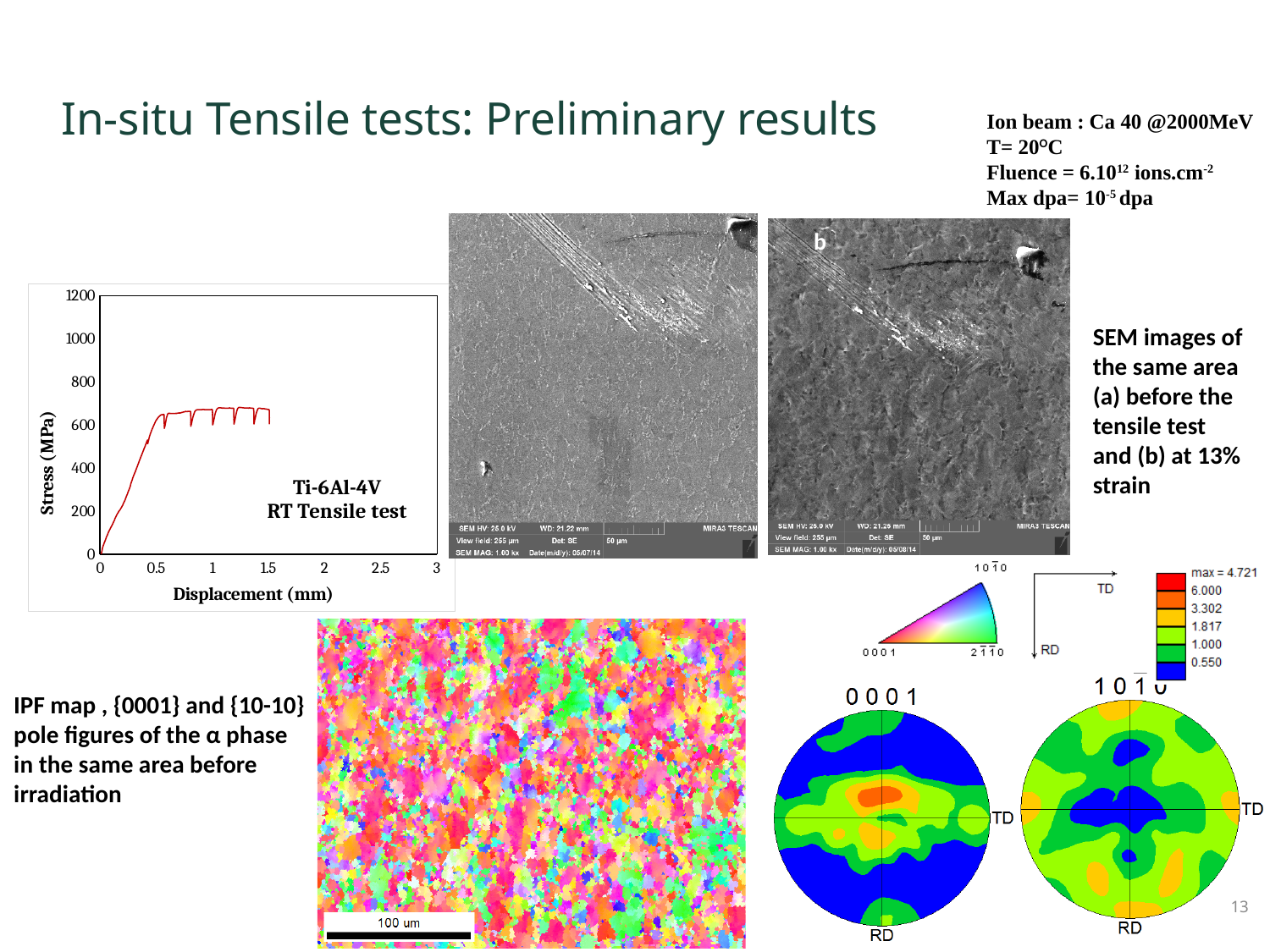
How many curves are plotted in the stress-displacement chart? 1 What is the label of the horizontal axis of the stress-displacement chart? Displacement (mm) What is the highest tick value shown on the horizontal axis of the stress-displacement chart? 3 In the stress-displacement chart, is the displacement at which the curve ends greater or less than 1 mm? greater In the stress-displacement chart, is the displacement at which the curve ends greater or less than 2 mm? less What kind of chart is the stress versus displacement plot on the left of the slide? line chart In the stress-displacement chart, is the maximum stress reached greater or less than 800 MPa? less What is the highest tick value shown on the vertical axis of the stress-displacement chart? 1200 What is the label of the vertical axis of the stress-displacement chart? Stress (MPa) How does the stress change along the displacement axis in the stress-displacement chart? rises steeply, then levels off into a plateau